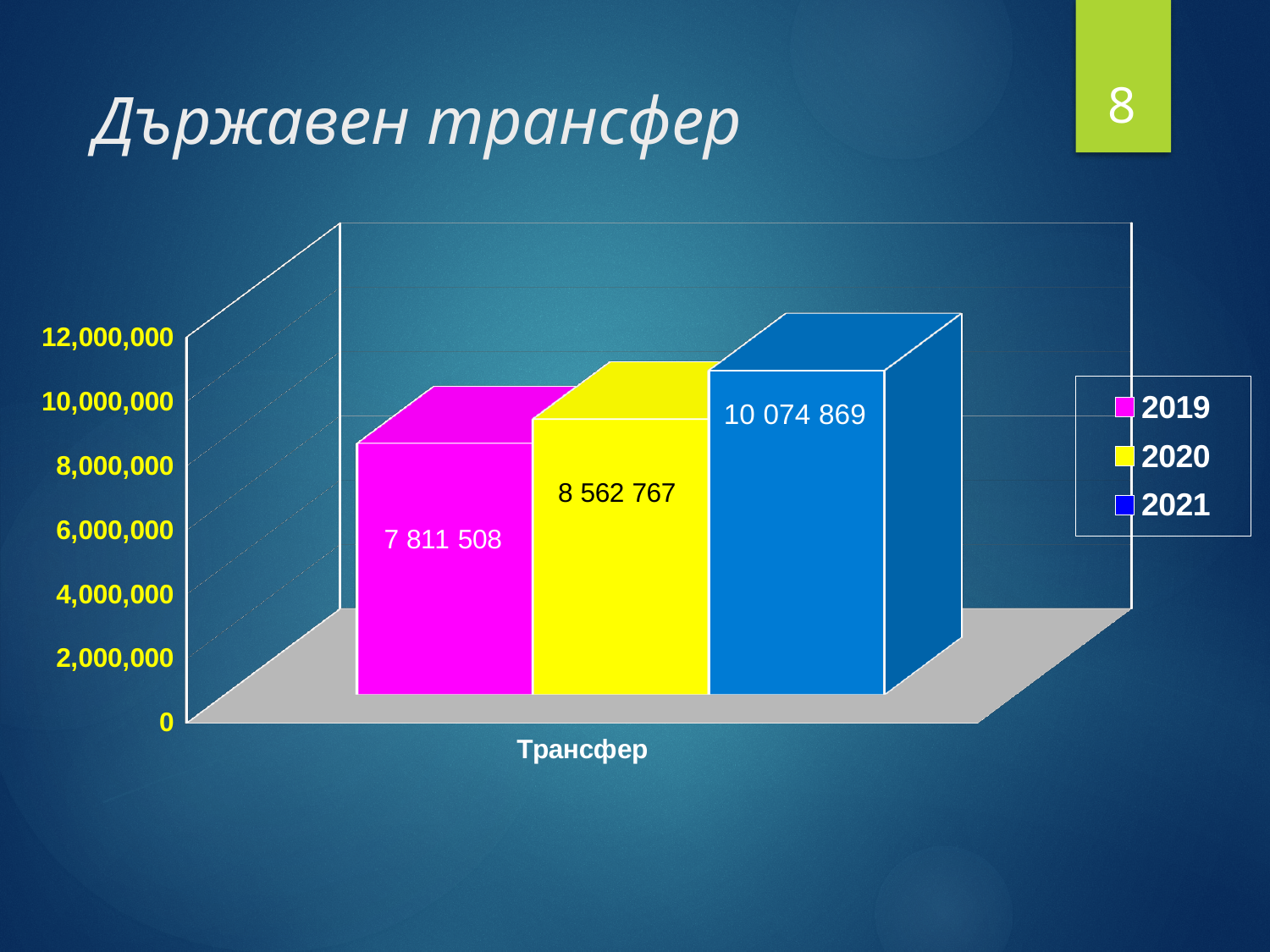
What is the value for 2020 in the Трансфер category? 8 562 767 Which year has the lowest transfer value? 2019 What is the difference between the 2020 and 2019 values? 751 259 What kind of chart is shown on the slide? Bar chart Is the value for 2021 greater or less than 10,000,000? greater What is the value for 2021 in the Трансфер category? 10 074 869 Which is larger, the value for 2020 or the value for 2021? 2021 What is the difference between the 2021 and 2019 values? 2 263 361 What is the value for 2019 in the Трансфер category? 7 811 508 What is the title of the slide containing the chart? Държавен трансфер How many series does the legend list? 3 Which year has the highest transfer value? 2021